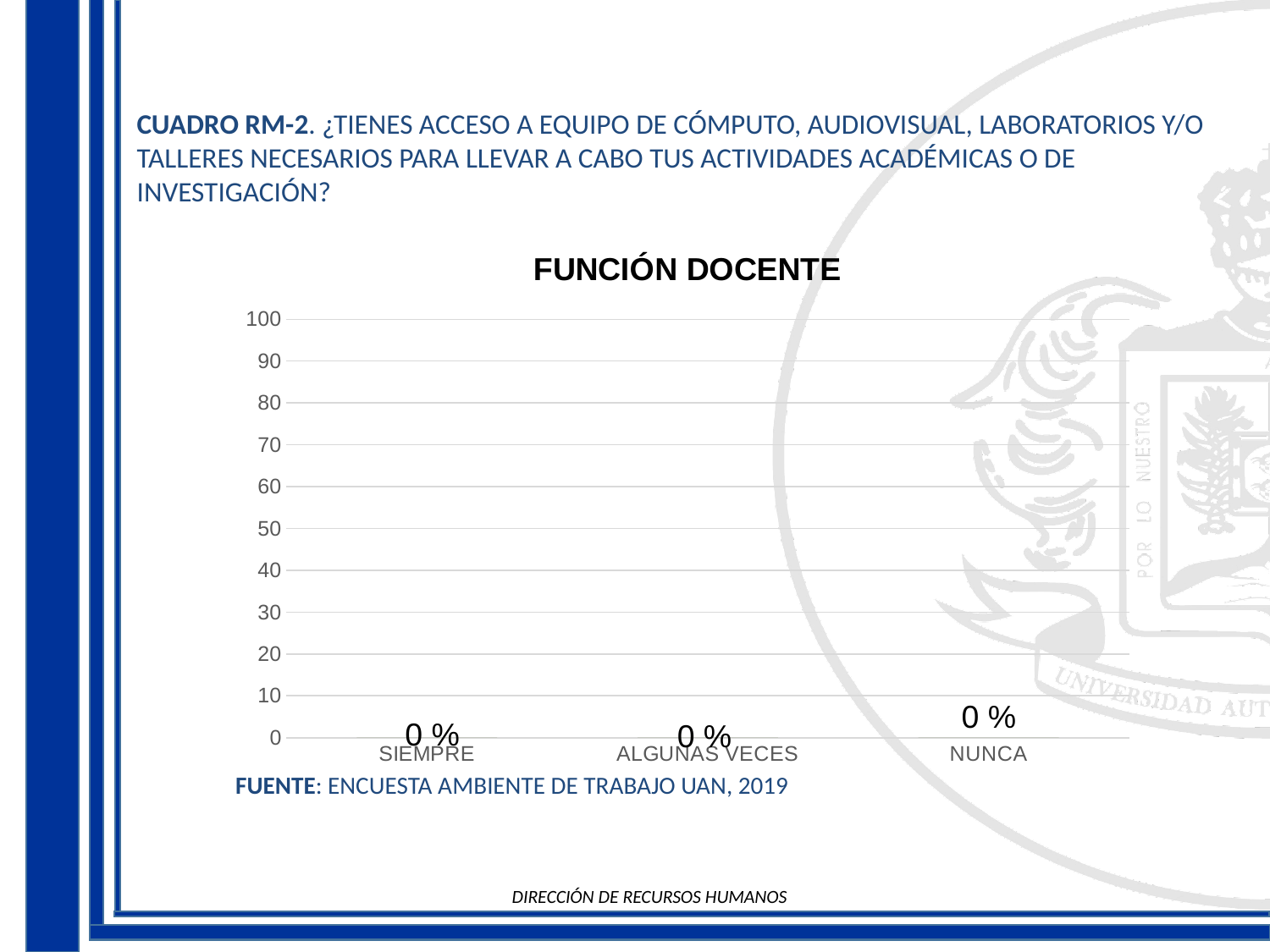
How many categories are shown on the x axis of the FUNCIÓN DOCENTE chart? 3 What is the highest value shown on the y axis of the FUNCIÓN DOCENTE chart? 100 Is the value for ALGUNAS VECES greater or less than 50? less What value is shown for SIEMPRE in the FUNCIÓN DOCENTE chart? 0 % What is the difference between the values for SIEMPRE and NUNCA in the FUNCIÓN DOCENTE chart? 0 % What is the title of the chart on the slide? FUNCIÓN DOCENTE Is the value for NUNCA greater or less than 10? less What value is shown for NUNCA in the FUNCIÓN DOCENTE chart? 0 % What value is shown for ALGUNAS VECES in the FUNCIÓN DOCENTE chart? 0 % What is the total of the three values shown in the FUNCIÓN DOCENTE chart? 0 %